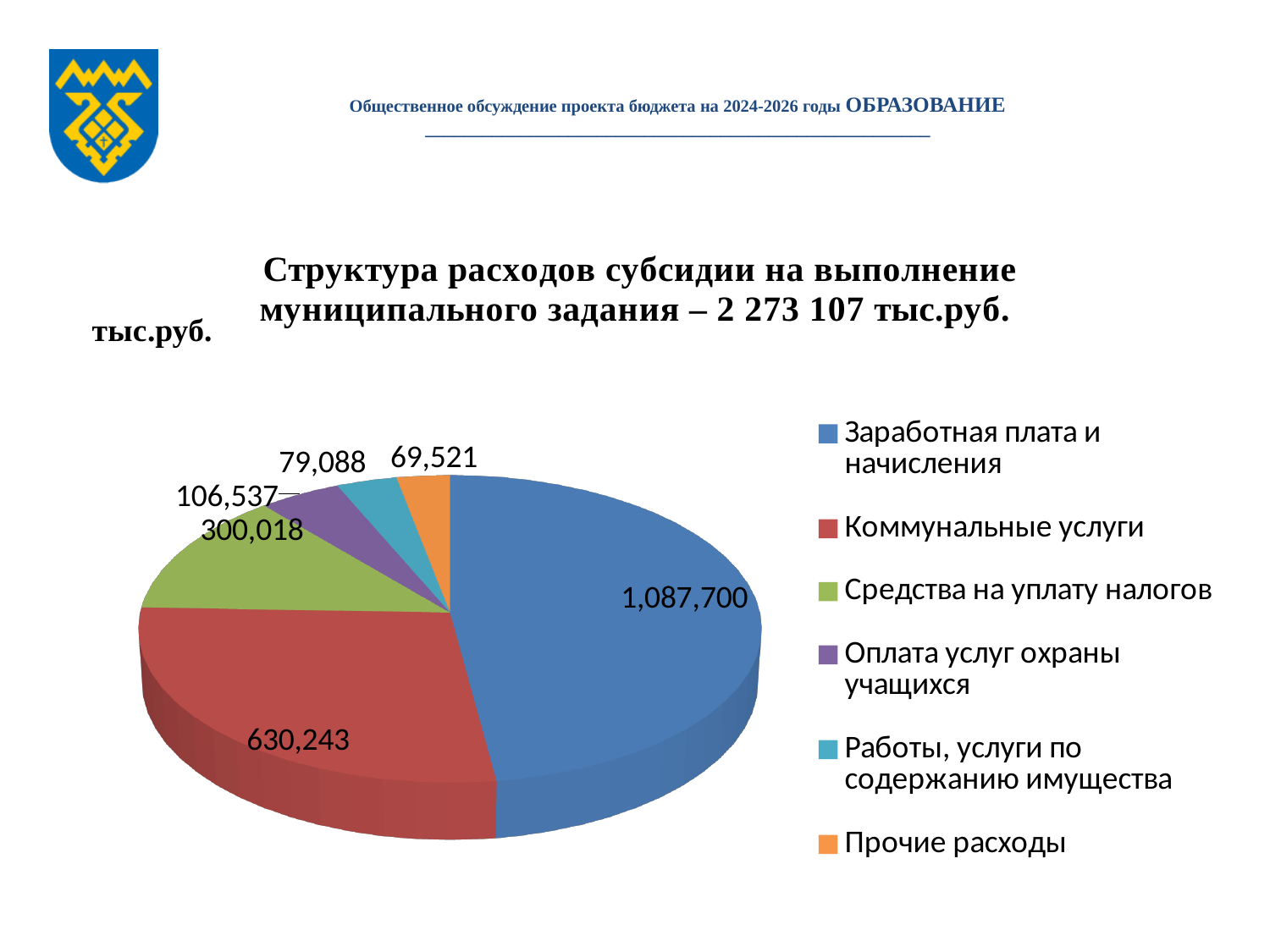
Which is larger: Работы, услуги по содержанию имущества or Прочие расходы? Работы, услуги по содержанию имущества Which category has the largest slice of the pie? Заработная плата и начисления What is the value for Заработная плата и начисления? 1,087,700 What is the value for Оплата услуг охраны учащихся? 106,537 What is the difference between the values for Средства на уплату налогов and Оплата услуг охраны учащихся? 193,481 How many categories does the legend list? 6 What is the value for Прочие расходы? 69,521 What type of chart is shown on the slide? Pie chart What is the value for Коммунальные услуги? 630,243 What colour is the slice for Средства на уплату налогов? Green Which category has the smallest slice of the pie? Прочие расходы What is the difference between the values for Заработная плата и начисления and Коммунальные услуги? 457,457